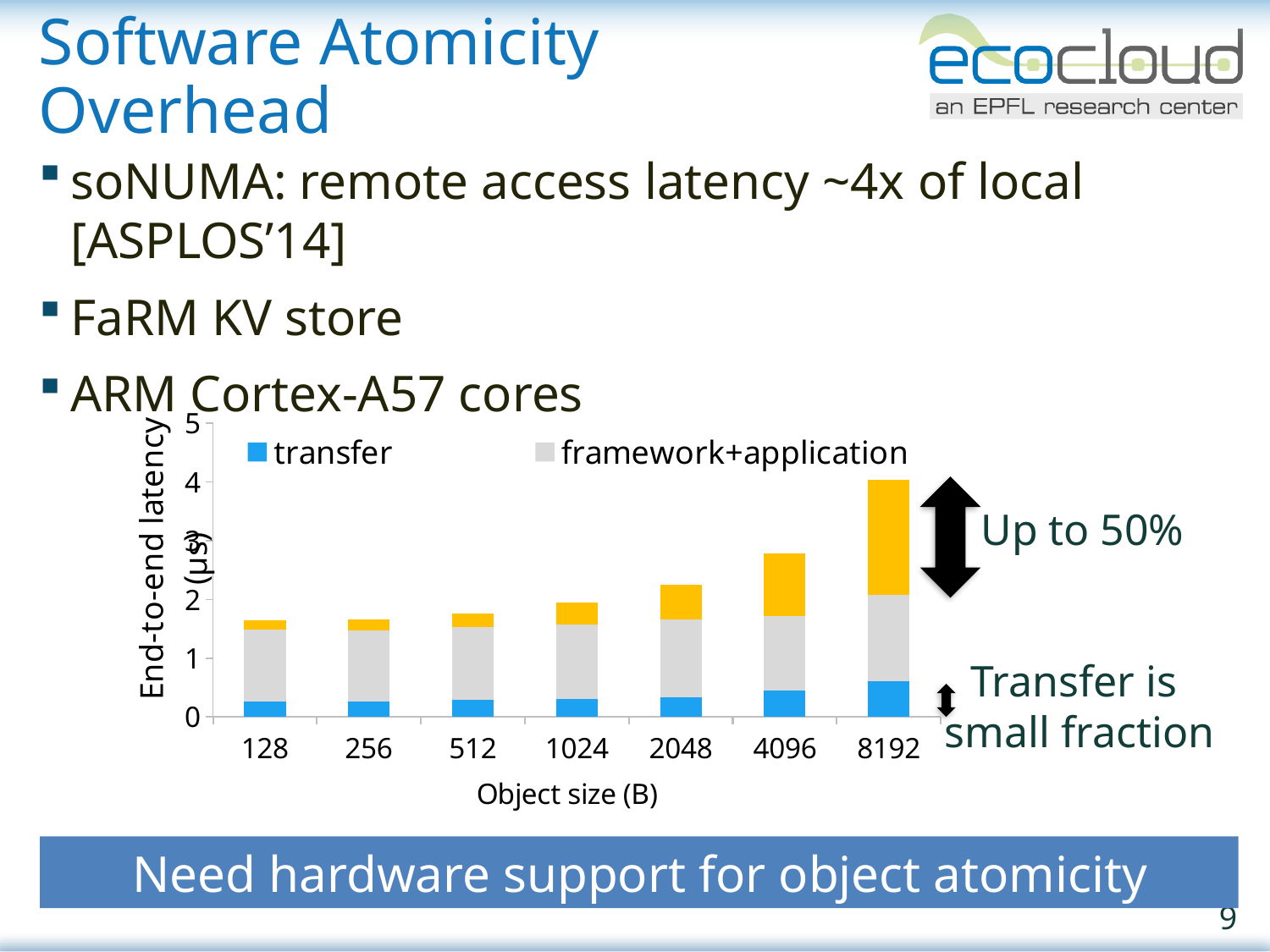
What is the label of the x axis? Object size (B) Is the transfer value for object size 8192 greater or less than 1? less Is the total end-to-end latency for object size 4096 greater or less than 2? greater Is the total end-to-end latency for object size 8192 greater or less than 3? greater Which colour represents the transfer series in the legend? blue Which has the larger total end-to-end latency, object size 4096 or 8192? 8192 Does the total end-to-end latency rise or fall as object size increases along the x axis? rise How many series does the chart's legend list? 2 How many object size categories are shown on the x axis? 7 Which object size has the highest total end-to-end latency? 8192 What kind of chart is shown on the slide? stacked bar chart